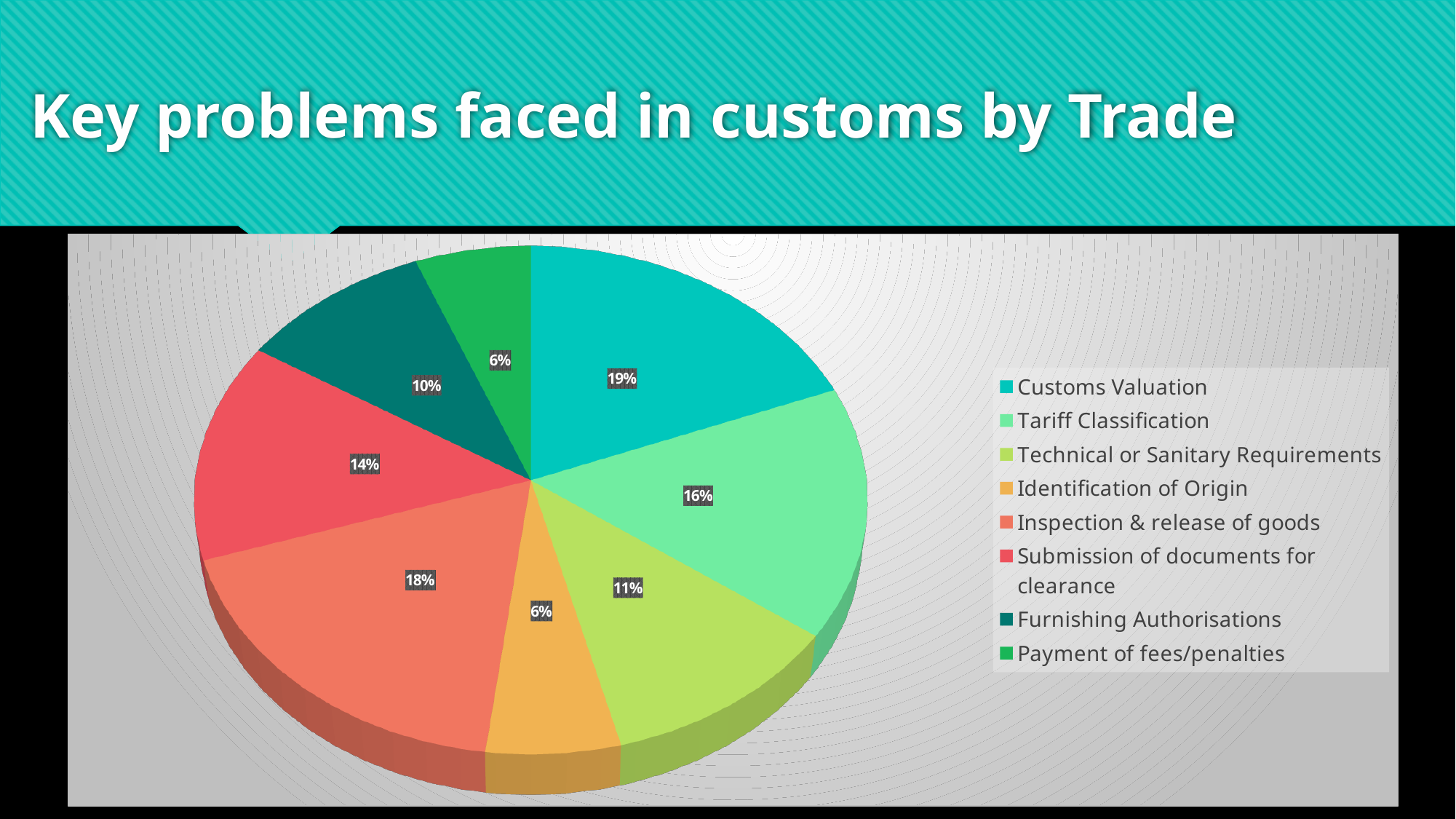
What is the difference in percentage points between Inspection & release of goods and Furnishing Authorisations? 8 What is the title of the slide containing the chart? Key problems faced in customs by Trade Which category has the largest share of the pie? Customs Valuation What percentage is shown for Submission of documents for clearance? 14% What percentage is shown for Technical or Sanitary Requirements? 11% What share of the pie does Customs Valuation represent? 19% What kind of chart is shown on the slide? pie chart How many categories does the legend list? 8 What percentage is shown for Tariff Classification? 16% What percentage is shown for Furnishing Authorisations? 10% Which is larger, the share for Tariff Classification or the share for Submission of documents for clearance? Tariff Classification What percentage is shown for Inspection & release of goods? 18%